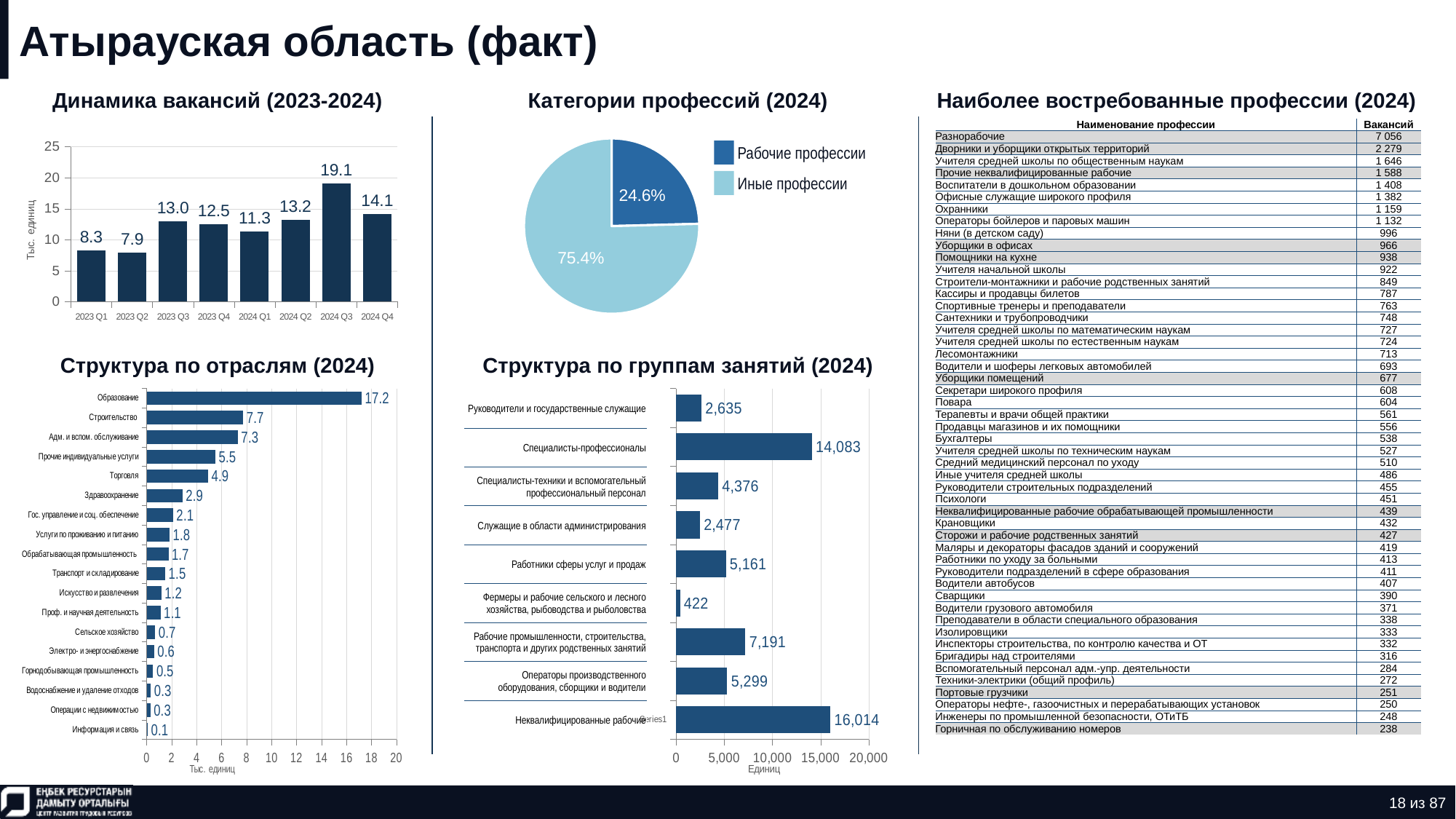
In the chart 'Категории профессий (2024)', what share of the pie is 'Рабочие профессии'? 24.6% In the chart 'Динамика вакансий (2023-2024)', which quarter has the lowest value? 2023 Q2 What kind of chart is 'Категории профессий (2024)'? pie chart In the chart 'Структура по отраслям (2024)', which category has the highest value? Образование In the chart 'Категории профессий (2024)', how many entries does the legend list? 2 In the chart 'Структура по группам занятий (2024)', what is the value for 'Специалисты-профессионалы'? 14,083 In the chart 'Динамика вакансий (2023-2024)', what is the value for 2024 Q3? 19.1 In the chart 'Структура по отраслям (2024)', what is the value for 'Строительство'? 7.7 In the chart 'Структура по группам занятий (2024)', which is larger: 'Работники сферы услуг и продаж' or 'Операторы производственного оборудования, сборщики и водители'? Операторы производственного оборудования, сборщики и водители In the chart 'Динамика вакансий (2023-2024)', how many quarters are plotted? 8 In the chart 'Структура по группам занятий (2024)', which category has the lowest value? Фермеры и рабочие сельского и лесного хозяйства, рыбоводства и рыболовства In the chart 'Динамика вакансий (2023-2024)', what is the difference between the values for 2024 Q3 and 2024 Q4? 5.0